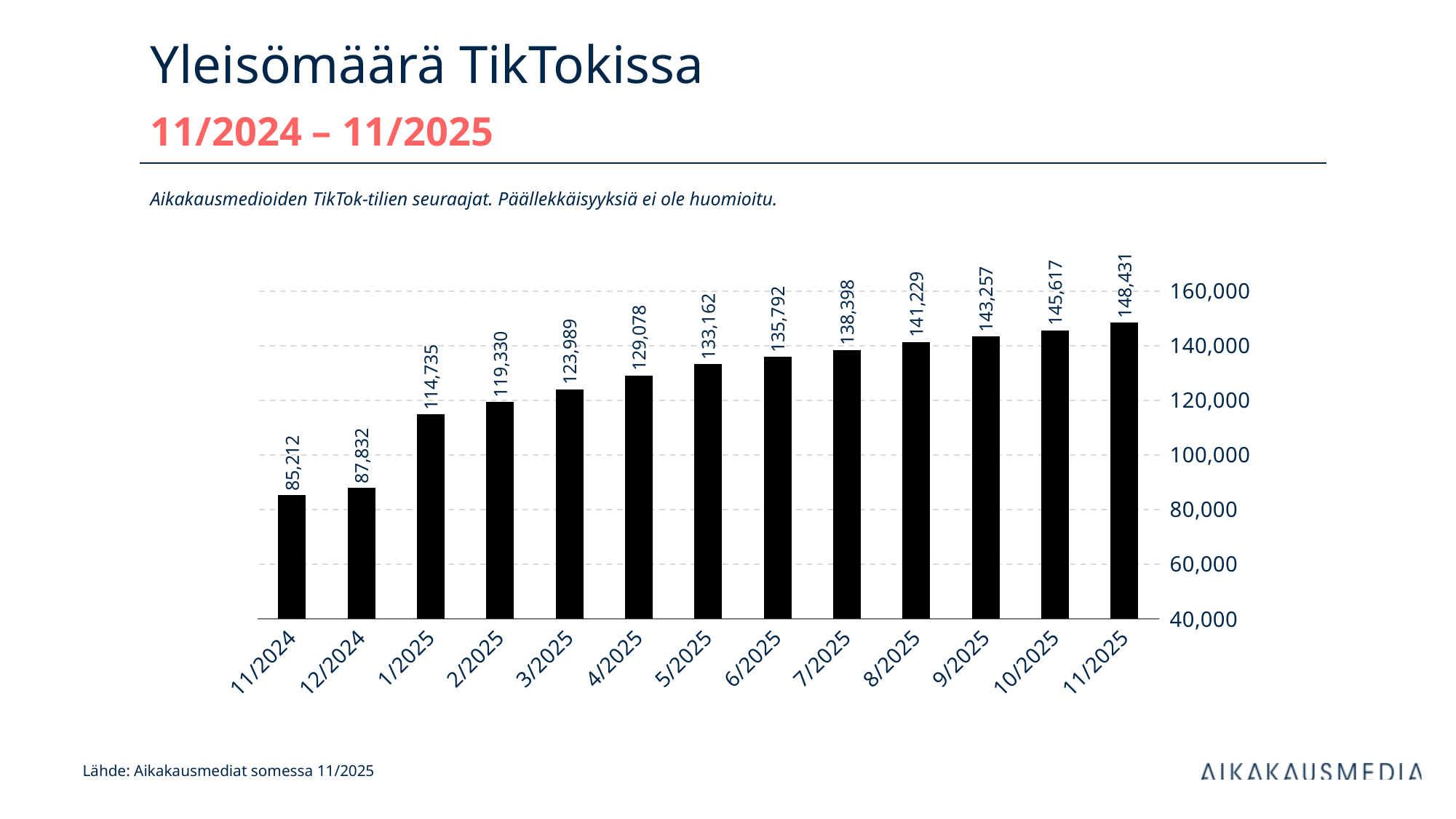
What is the value for 11/2025? 148,431 What is the value for 5/2025? 133,162 What is the value for 11/2024? 85,212 What kind of chart is shown on the slide? bar chart How many months are shown on the x axis? 13 Which month has the lowest value? 11/2024 Is the value for 2/2025 greater or less than 120,000? less What is the difference between the values for 11/2025 and 11/2024? 63,219 What is the difference between the values for 1/2025 and 12/2024? 26,903 Which month has the highest value? 11/2025 Which is larger, the value for 3/2025 or the value for 7/2025? 7/2025 Do the values rise or fall from 11/2024 to 11/2025? rise